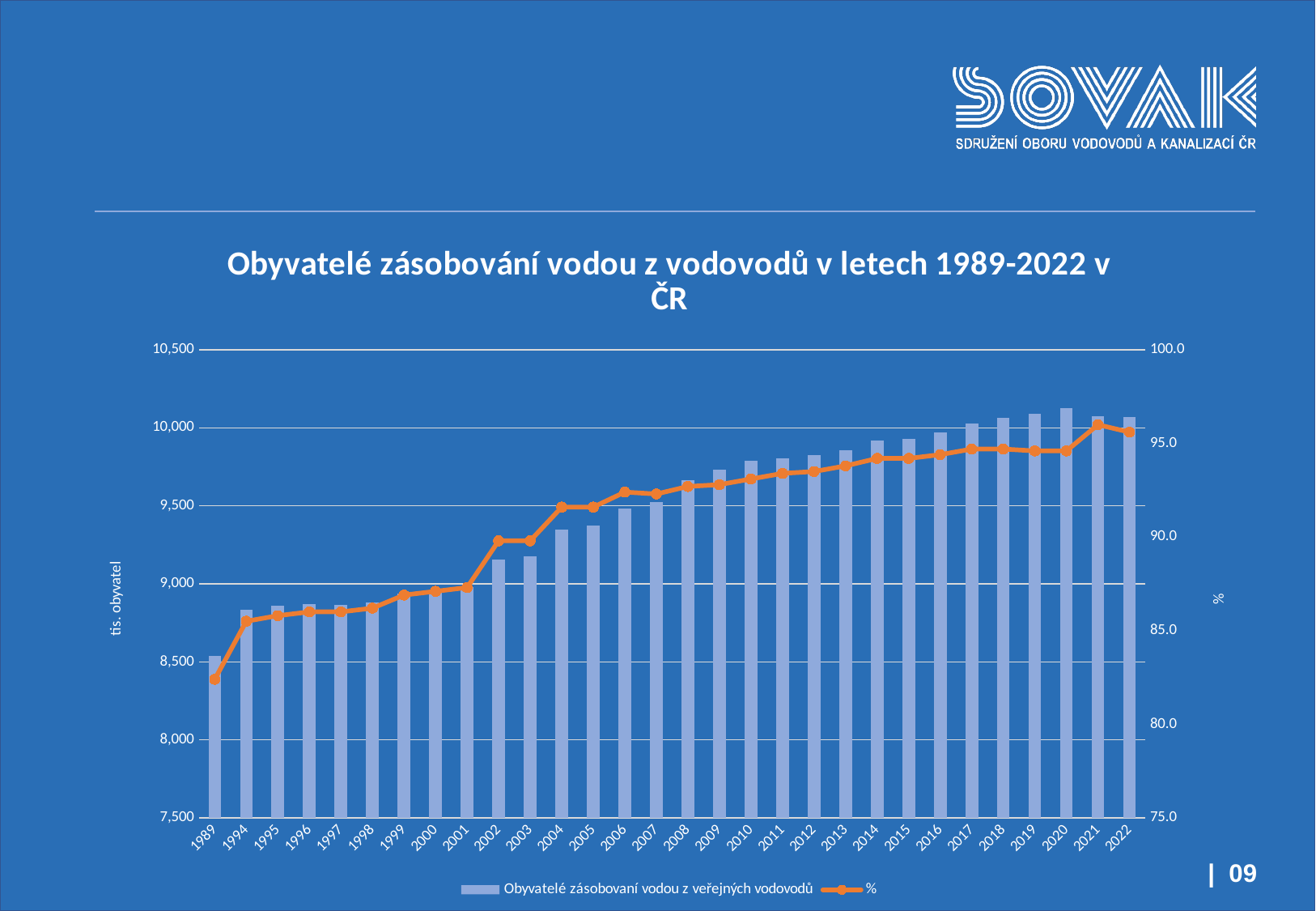
Is the bar value for 1994 greater or less than 9,000? less Which year has the shortest bar for Obyvatelé zásobovaní vodou z veřejných vodovodů? 1989 Do the bar values generally rise or fall from 1989 to 2022? rise How many series does the legend list? 2 Is the bar value for 2020 greater or less than 10,000? greater Is the % value for 2021 greater or less than 95.0? greater In which year is the % line at its lowest point? 1989 How many years are shown on the x axis? 30 What kind of chart is shown on the slide? A bar chart combined with a line chart Which year has the tallest bar for Obyvatelé zásobovaní vodou z veřejných vodovodů? 2020 In which year does the % line reach its highest point? 2021